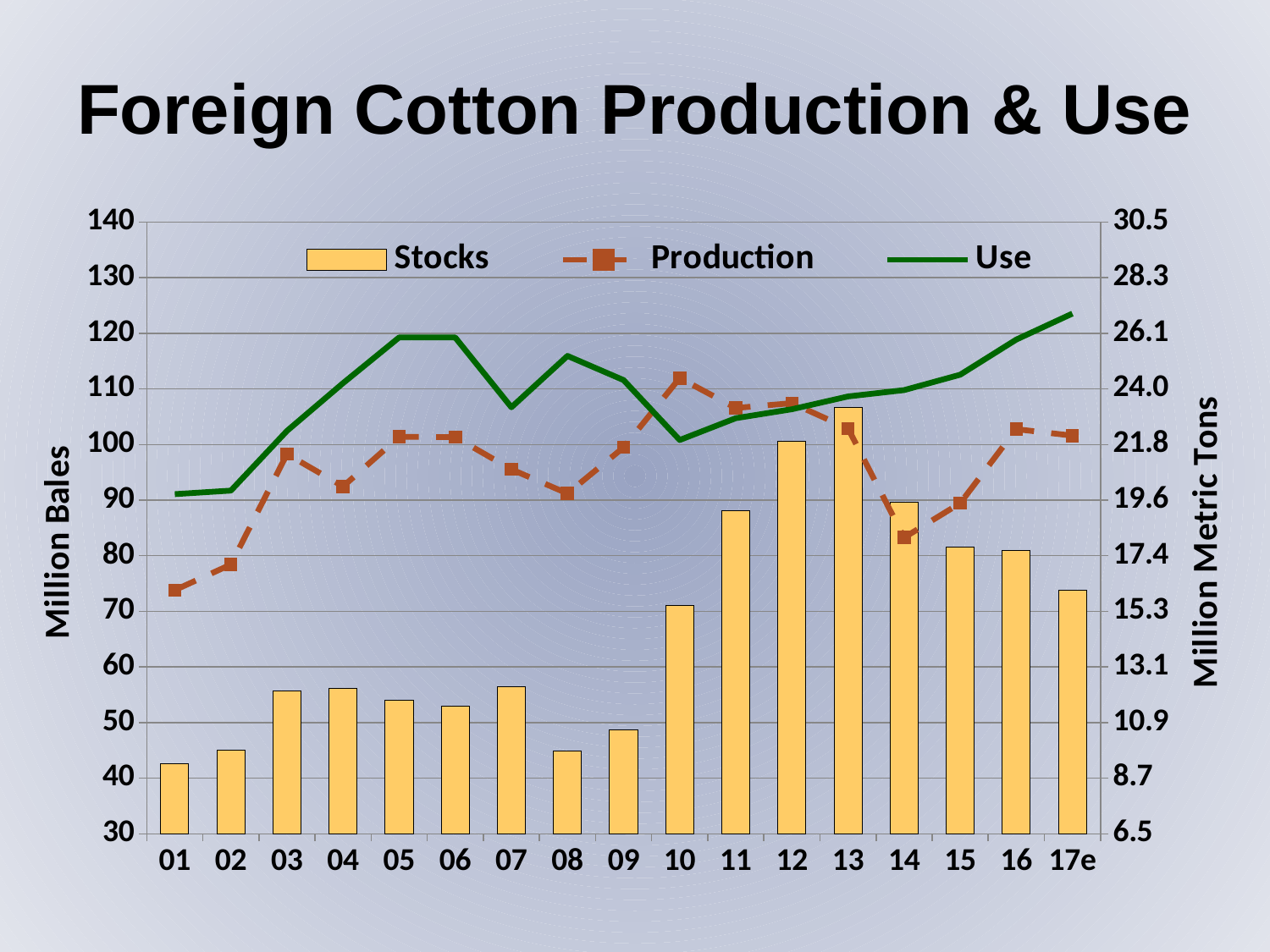
Does the Use line rise or fall from 14 to 17e? rise What is the label on the left vertical axis? Million Bales Which year has larger Stocks, 03 or 13? 13 Is the Stocks value for 01 greater or less than 50 million bales? less In which year are Stocks highest? 13 What type of chart is shown on the slide? Combination bar and line chart How many series does the legend list? 3 Is the Stocks value for 17e greater or less than 70 million bales? greater How many years are shown along the x axis? 17 In which year are Stocks lowest? 01 Is the Stocks value for 13 greater or less than 100 million bales? greater In which year does the Use line reach its highest point? 17e